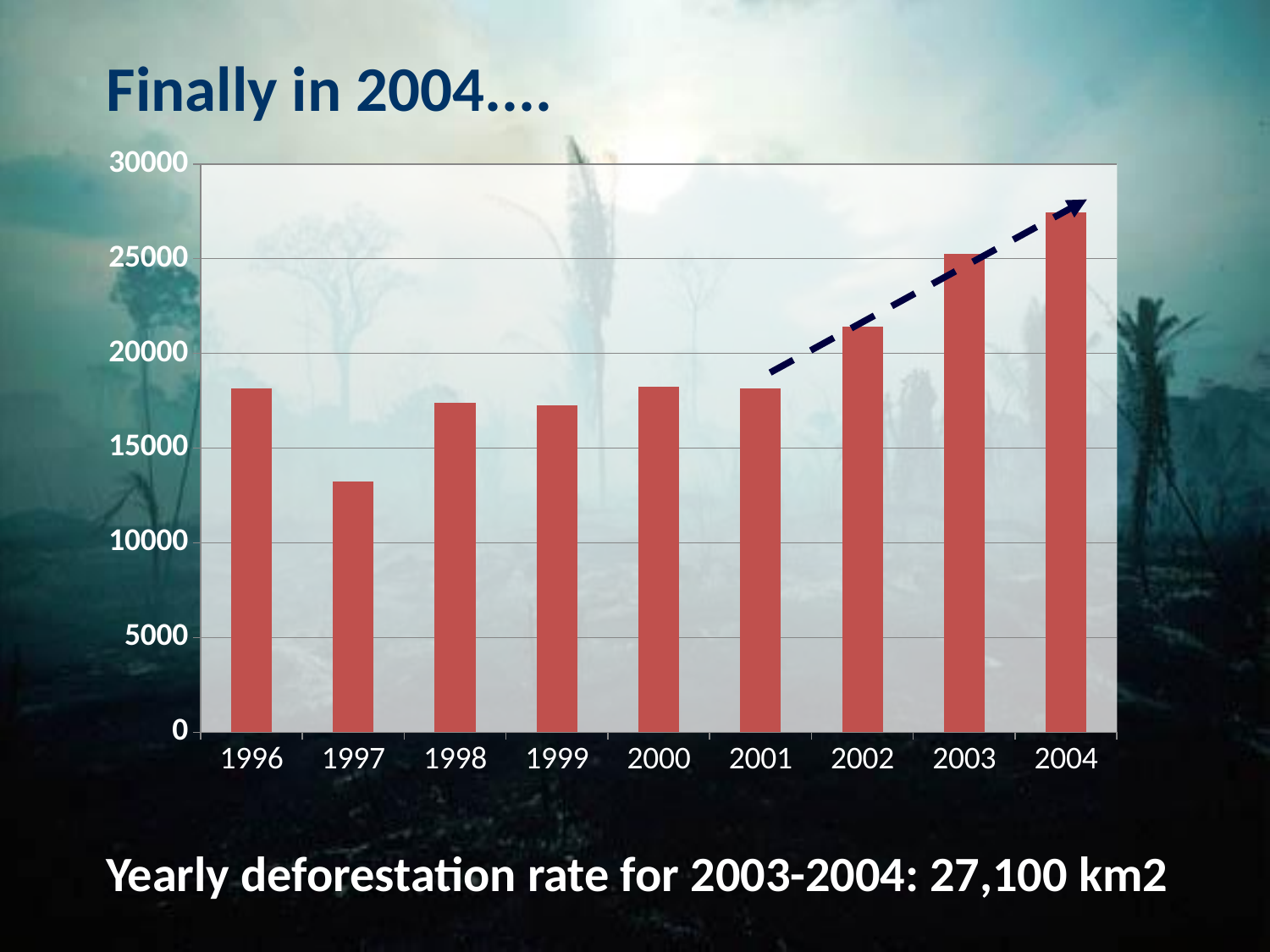
Which year has the lowest bar in the chart? 1997 Which year has the highest bar in the chart? 2004 Do the values rise or fall from 2001 to 2004? rise According to the caption below the chart, what was the yearly deforestation rate for 2003-2004? 27,100 km2 Which year has the larger value, 1997 or 1998? 1998 How many years are shown on the x axis of the chart? 9 What kind of chart is shown on the slide? bar chart Which year has the larger value, 2001 or 2002? 2002 Is the value for 1997 greater or less than 15000? less Is the value for 2004 greater or less than 25000? greater Is the value for 2002 greater or less than 20000? greater